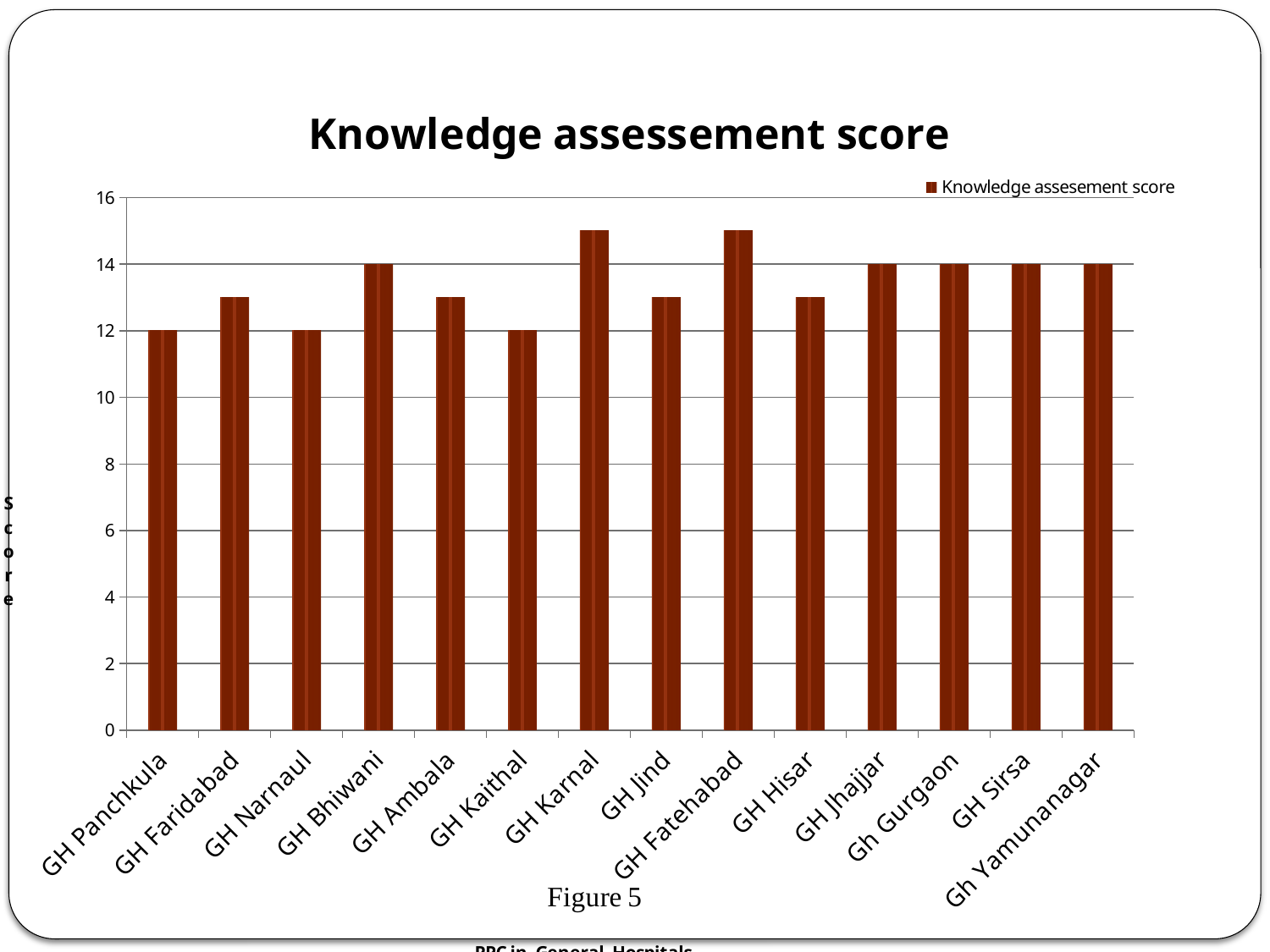
Is the value for GH Hisar greater or less than 14? less Which has a higher score, GH Karnal or GH Narnaul? GH Karnal How many series does the legend list? 1 What is the knowledge assessment score for GH Bhiwani? 14 What is the knowledge assessment score for Gh Yamunanagar? 14 What kind of chart is shown on the slide? Bar chart Is the value for GH Karnal greater or less than 14? greater How many general hospitals are shown on the x axis? 14 What is the knowledge assessment score for GH Kaithal? 12 Is the value for GH Faridabad greater or less than 12? greater What is the knowledge assessment score for GH Panchkula? 12 What is the difference between the scores of GH Sirsa and GH Narnaul? 2